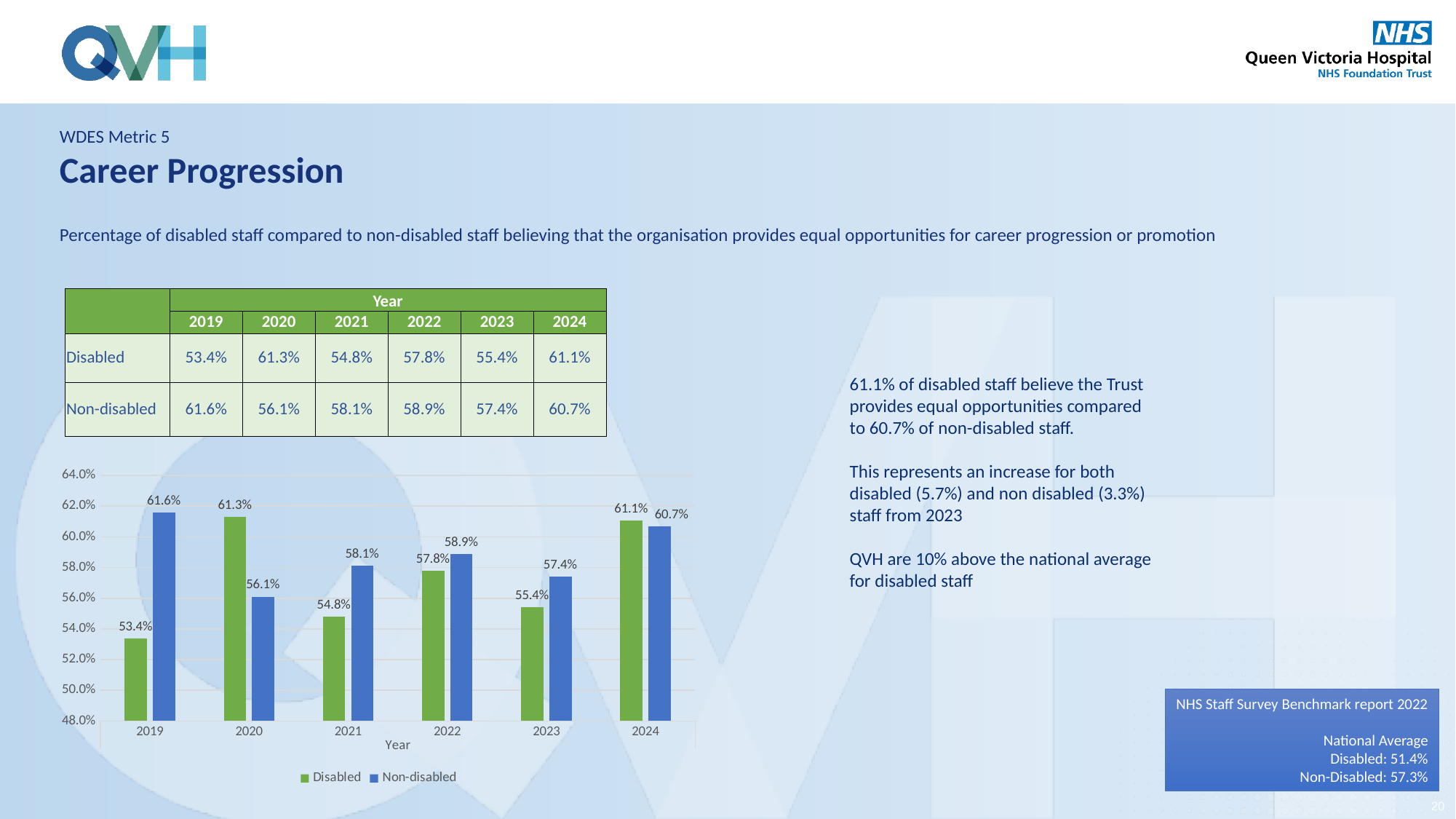
In which year is the Non-disabled value highest? 2019 What is the value for Disabled staff in 2019? 53.4% How many years are shown on the x axis of the chart? 6 What is the value for Disabled staff in 2024? 61.1% Is the Disabled value for 2021 greater or less than 56.0%? less What colour are the Disabled bars in the chart? green What is the value for Non-disabled staff in 2022? 58.9% Which is larger in 2020, the Disabled value or the Non-disabled value? Disabled How many series does the chart legend list? 2 In which year is the Disabled value lowest? 2019 What is the difference between the Non-disabled and Disabled values in 2019? 8.2% What kind of chart is shown on the slide? bar chart